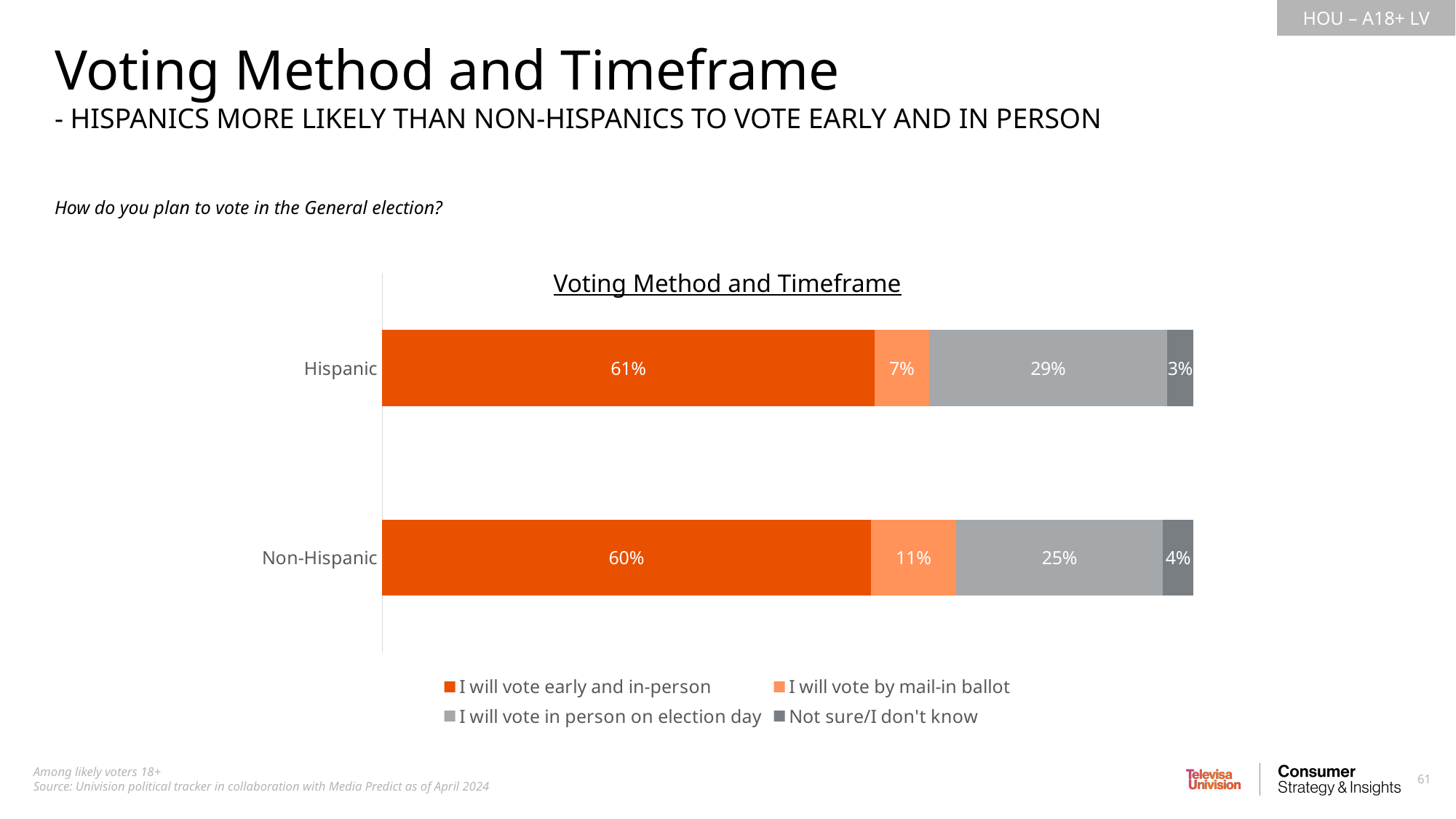
What percentage of Hispanic respondents say they will vote early and in-person? 61% Which voting method has the largest share among Hispanic respondents? I will vote early and in-person How many groups (categories) are shown on the chart? 2 What is the difference between the Non-Hispanic and Hispanic shares for voting by mail-in ballot? 4% What is the difference between the Hispanic and Non-Hispanic shares for voting in person on election day? 4% What percentage of Non-Hispanic respondents say they will vote by mail-in ballot? 11% What percentage of Non-Hispanic respondents answered Not sure/I don't know? 4% Which response has the smallest share among Non-Hispanic respondents? Not sure/I don't know What percentage of Hispanic respondents say they will vote in person on election day? 29% Which group has the higher share saying they will vote in person on election day, Hispanic or Non-Hispanic? Hispanic How many series does the legend list? 4 What type of chart is shown on the slide? Stacked bar chart